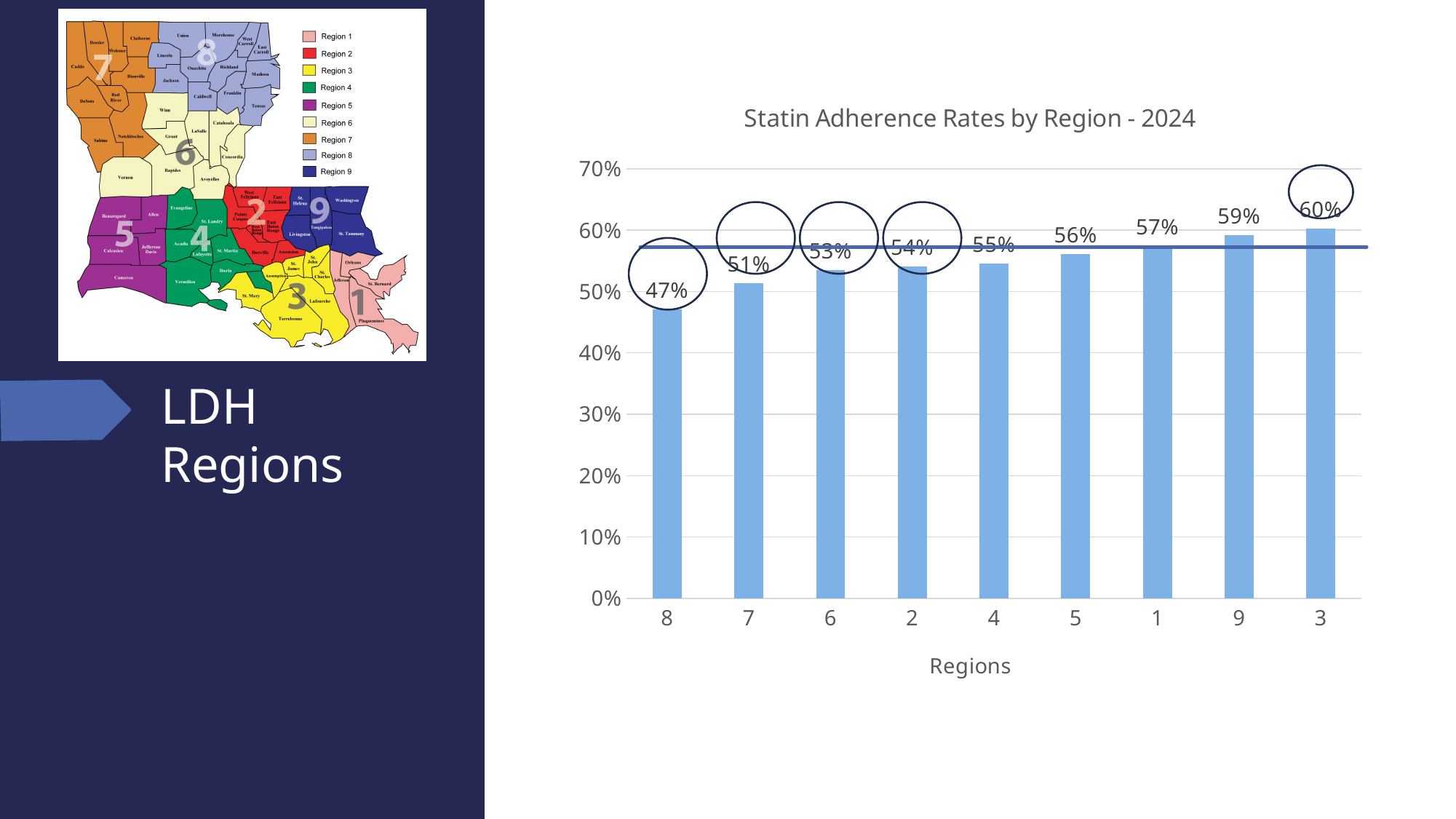
How many regions are shown on the chart? 9 What is the statin adherence rate for region 9? 59% What kind of chart is shown on the slide? Bar chart Which region has the lowest statin adherence rate? 8 What is the statin adherence rate for region 5? 56% What is the difference between the adherence rates of region 1 and region 6? 4% Is the value for region 2 greater or less than 50%? greater Which has a higher statin adherence rate, region 7 or region 4? Region 4 Which region has the highest statin adherence rate? 3 What is the difference between the adherence rates of region 3 and region 8? 13% What is the statin adherence rate for region 8? 47% What is the title of the chart? Statin Adherence Rates by Region - 2024